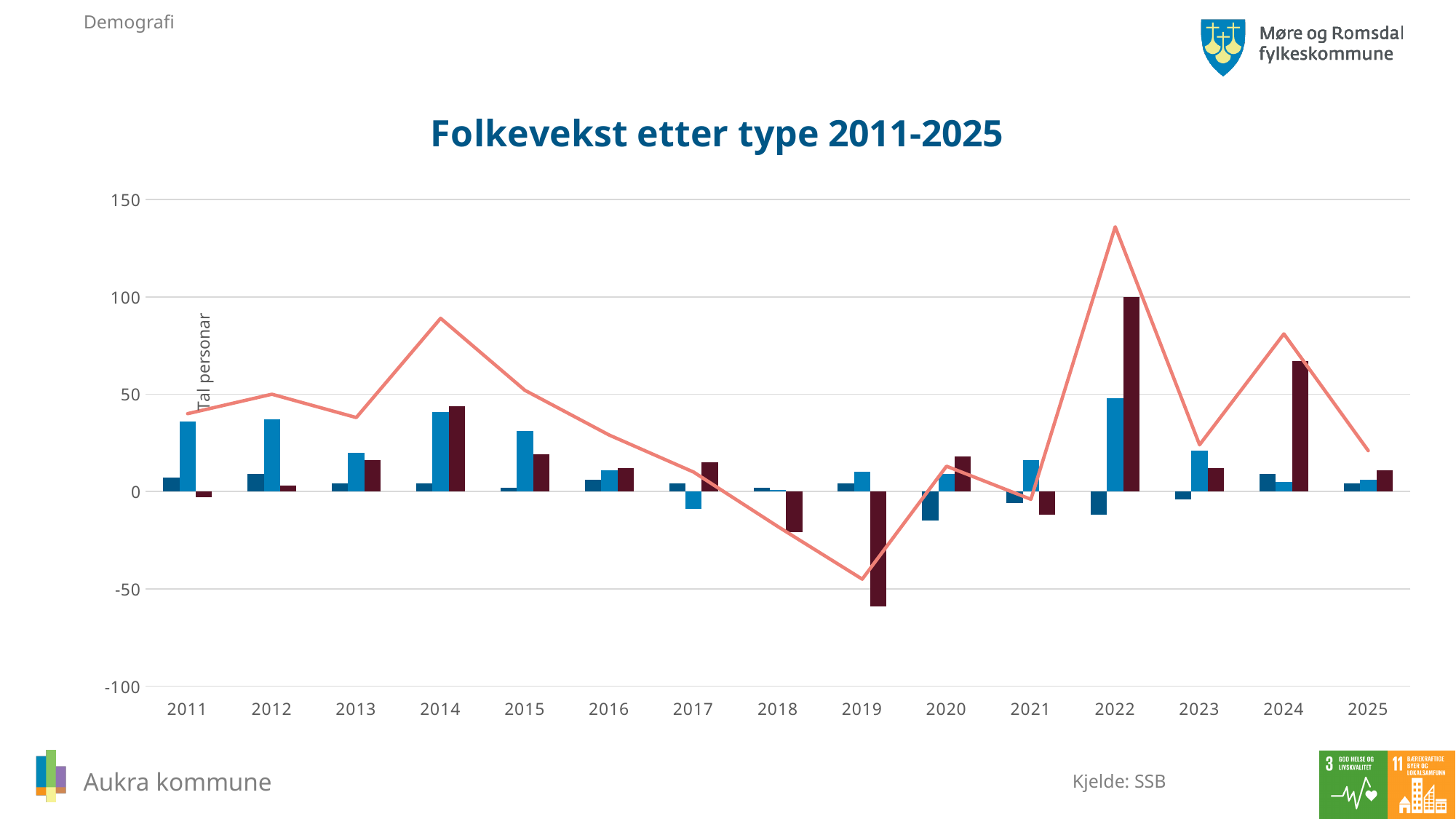
What kind of chart is shown on the slide? A bar chart combined with a line What is the title of the chart? Folkevekst etter type 2011-2025 What is the label on the vertical axis of the chart? Tal personar In which year does the line reach its lowest value? 2019 Which year has the larger line value, 2014 or 2022? 2022 Is the value of the line in 2019 greater or less than 0? less How many years are shown along the x axis of the chart? 15 Is the value of the line in 2014 greater or less than 50? greater Is the value of the dark red bar in 2019 greater or less than -50? less In which year does the line reach its highest value? 2022 Does the line rise or fall from 2022 to 2023? fall